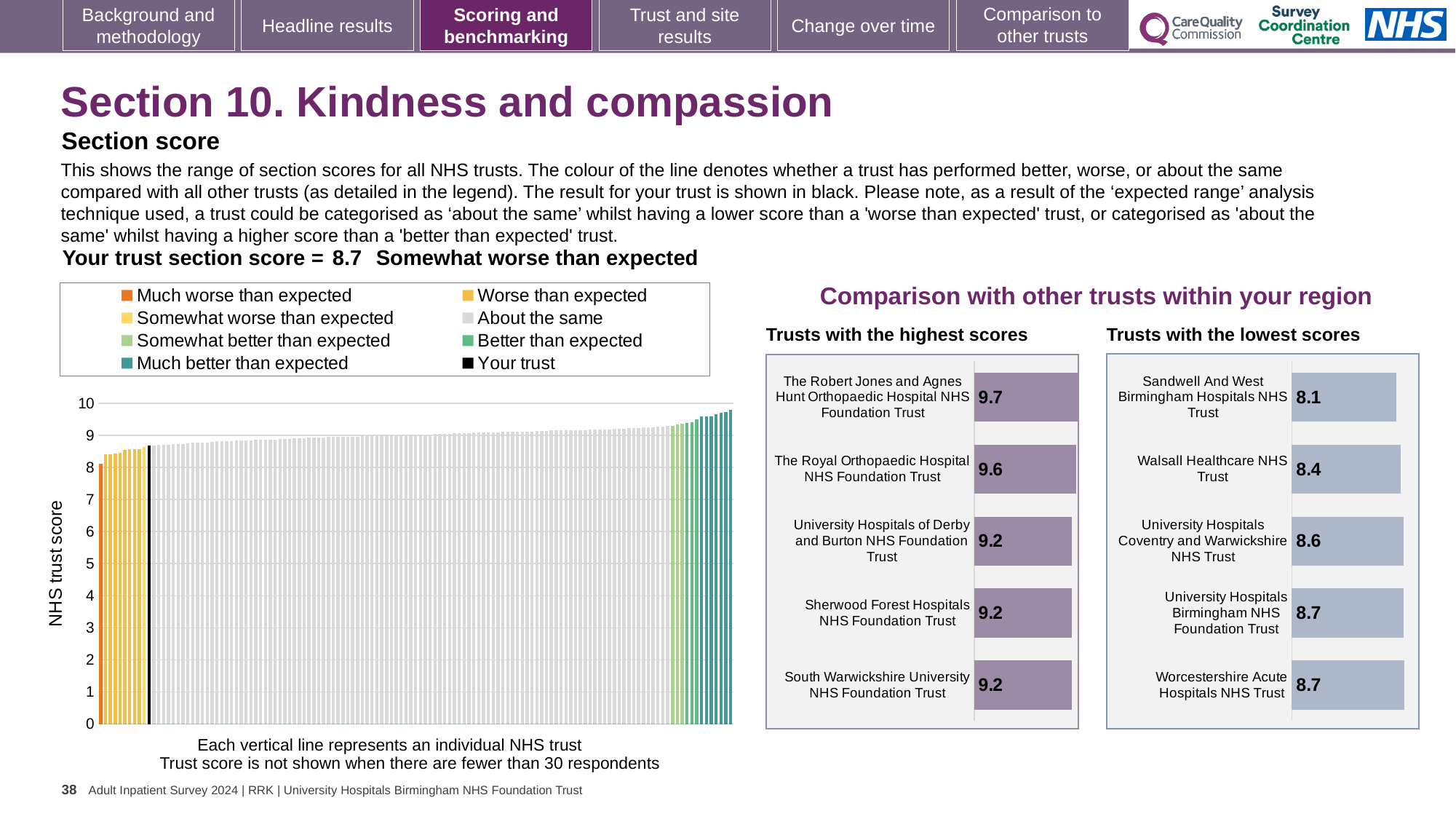
In the 'Trusts with the lowest scores' chart, which trust has the lowest score? Sandwell And West Birmingham Hospitals NHS Trust In the 'Trusts with the highest scores' chart, which has the larger score: The Royal Orthopaedic Hospital NHS Foundation Trust or Sherwood Forest Hospitals NHS Foundation Trust? The Royal Orthopaedic Hospital NHS Foundation Trust What is the label on the y axis of the large chart on the left? NHS trust score How many trusts are listed in the 'Trusts with the lowest scores' chart? 5 In the 'Trusts with the lowest scores' chart, what is the difference between the scores of Worcestershire Acute Hospitals NHS Trust and Sandwell And West Birmingham Hospitals NHS Trust? 0.6 What type of chart is the large chart on the left showing NHS trust scores? Bar chart How many entries does the legend of the large chart on the left list? 8 In the 'Trusts with the lowest scores' chart, what is the score for Walsall Healthcare NHS Trust? 8.4 In the 'Trusts with the lowest scores' chart, what is the score for Sandwell And West Birmingham Hospitals NHS Trust? 8.1 In the large chart on the left, do the trust scores rise or fall from left to right along the x axis? Rise In the 'Trusts with the highest scores' chart, what is the score for The Robert Jones and Agnes Hunt Orthopaedic Hospital NHS Foundation Trust? 9.7 In the 'Trusts with the highest scores' chart, which trust has the highest score? The Robert Jones and Agnes Hunt Orthopaedic Hospital NHS Foundation Trust